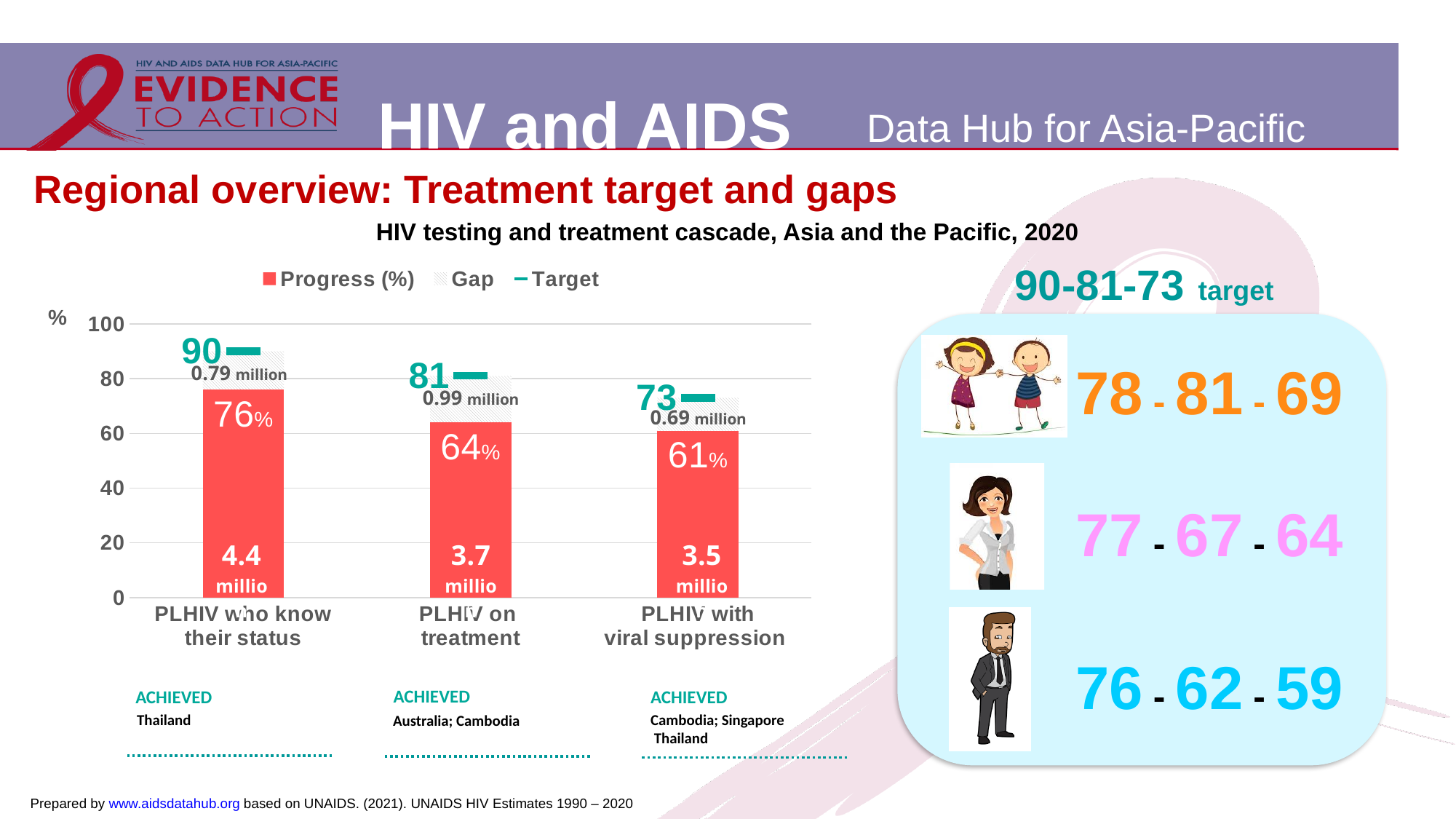
What is the progress percentage for PLHIV who know their status? 76% How many series does the chart legend list? 3 Which category has the highest progress percentage? PLHIV who know their status What is the target value shown for PLHIV on treatment? 81 What is the difference between the target and the progress percentage for PLHIV who know their status? 14 Which category has the lowest progress percentage? PLHIV with viral suppression What is the progress percentage for PLHIV with viral suppression? 61% How many categories are shown on the x axis of the chart? 3 What is the gap shown for PLHIV with viral suppression? 0.69 million What type of chart is used to show the HIV testing and treatment cascade? Bar chart What is the progress percentage for PLHIV on treatment? 64% Is the progress percentage for PLHIV on treatment greater or less than the target of 81? less